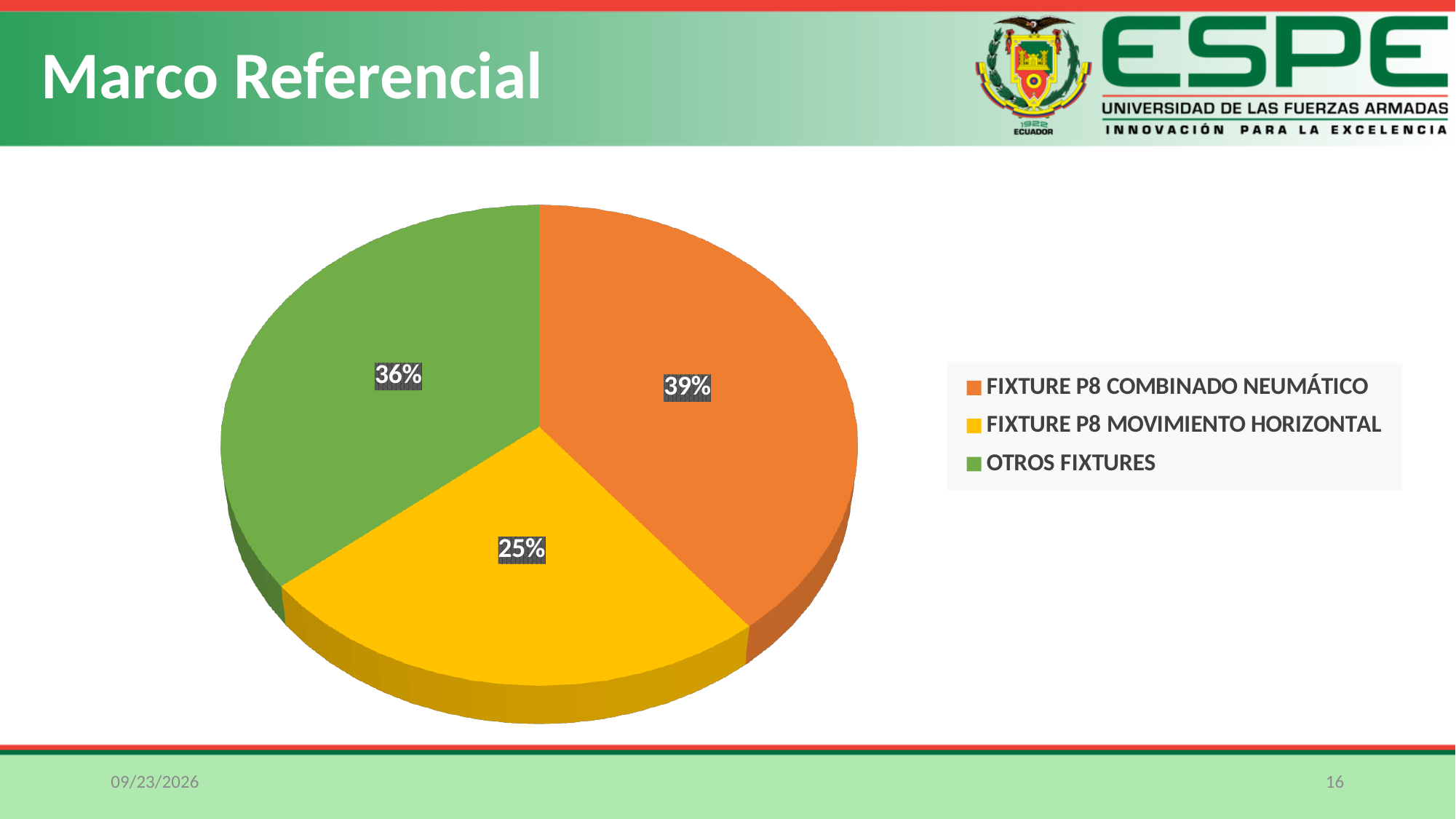
What kind of chart is shown on the slide? Pie chart What share of the pie does FIXTURE P8 MOVIMIENTO HORIZONTAL represent? 25% Which category has the smallest slice of the pie? FIXTURE P8 MOVIMIENTO HORIZONTAL Which is larger, the share for OTROS FIXTURES or the share for FIXTURE P8 MOVIMIENTO HORIZONTAL? OTROS FIXTURES What is the difference in percentage points between OTROS FIXTURES and FIXTURE P8 MOVIMIENTO HORIZONTAL? 11% Which category has the largest slice of the pie? FIXTURE P8 COMBINADO NEUMÁTICO What share of the pie does OTROS FIXTURES represent? 36% How many slices does the pie chart have? 3 What is the difference in percentage points between FIXTURE P8 COMBINADO NEUMÁTICO and FIXTURE P8 MOVIMIENTO HORIZONTAL? 14% What share of the pie does FIXTURE P8 COMBINADO NEUMÁTICO represent? 39% How many entries does the legend list? 3 What colour is the slice for OTROS FIXTURES? Green